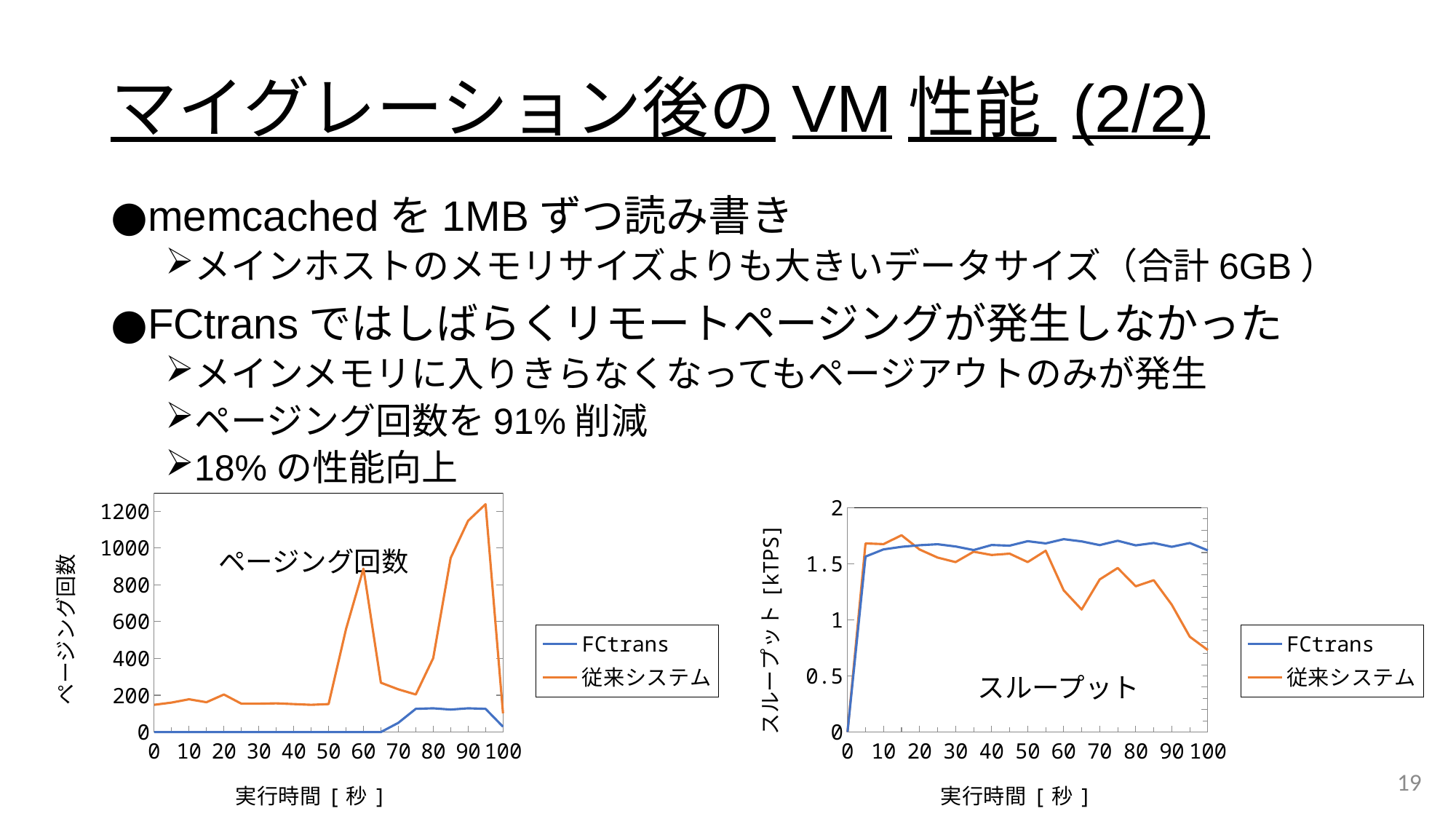
What kind of chart is the left chart titled ページング回数? line chart In the right chart (スループット), is the value for FCtrans at 100 seconds greater or less than 1.5? greater In the left chart (ページング回数), is the value for FCtrans at 80 seconds greater or less than 200? less In the right chart (スループット), does the 従来システム line rise or fall overall between 60 and 100 seconds? fall In the left chart (ページング回数), is the value for 従来システム at 60 seconds greater or less than 800? greater In the right chart (スループット), which series has the higher value at 100 seconds, FCtrans or 従来システム? FCtrans In the left chart (ページング回数), which series has the higher value at 95 seconds, FCtrans or 従来システム? 従来システム In the right chart (スループット), what is the label of the y axis? スループット [kTPS] In the left chart (ページング回数), which series is plotted in orange? 従来システム How many series does the legend of the right chart (スループット) list? 2